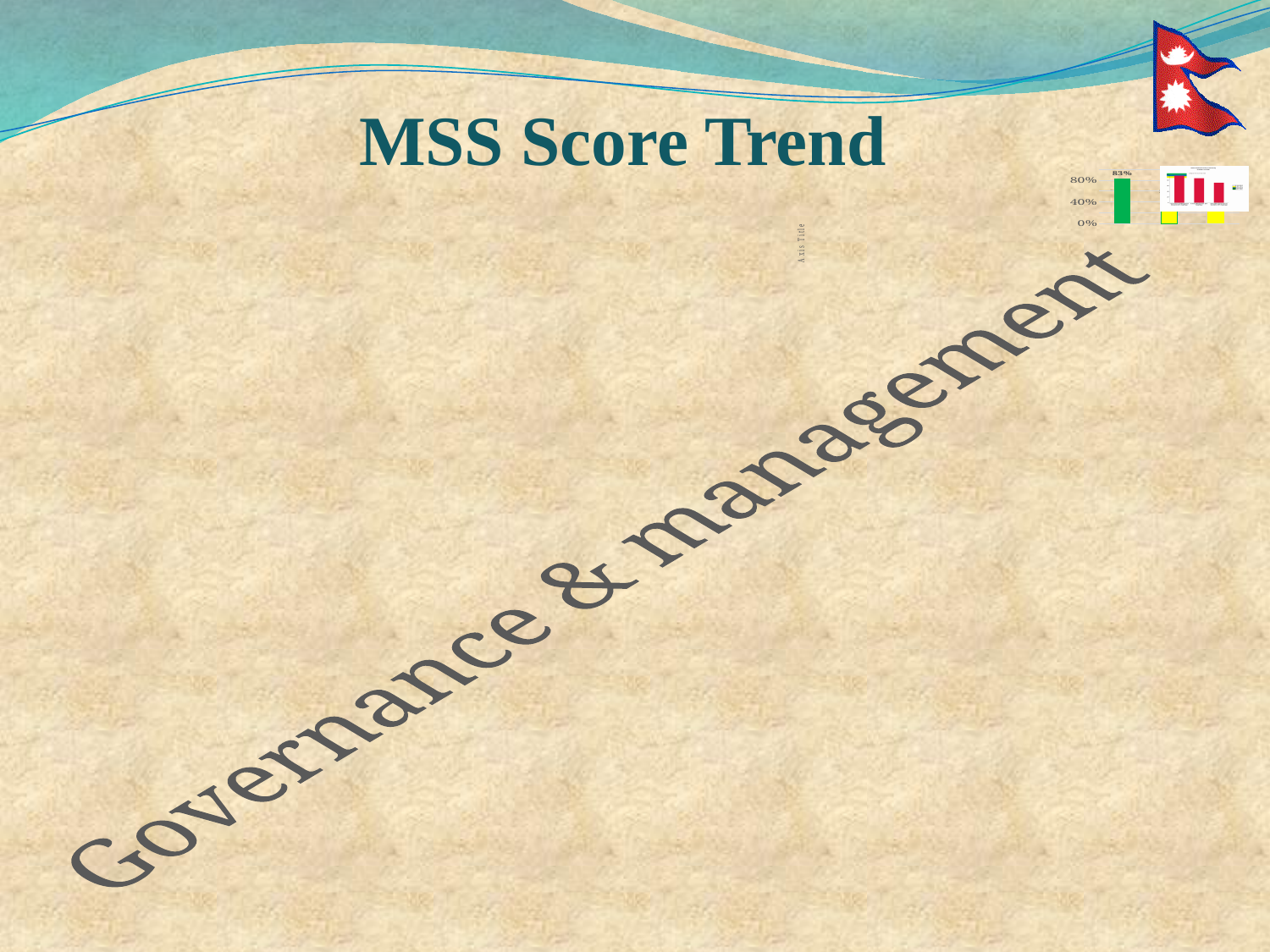
What text is shown as the vertical axis title of the chart? Axis Title What kind of chart is shown in the top-right corner of the slide? bar chart What value is printed above the tall green bar in the chart? 83% Which bar in the chart is the tallest? the green bar Are the yellow bars in the chart greater or less than 40%? less Is the value of the green bar greater or less than 80%? greater What is the highest tick label shown on the chart's vertical axis? 80%